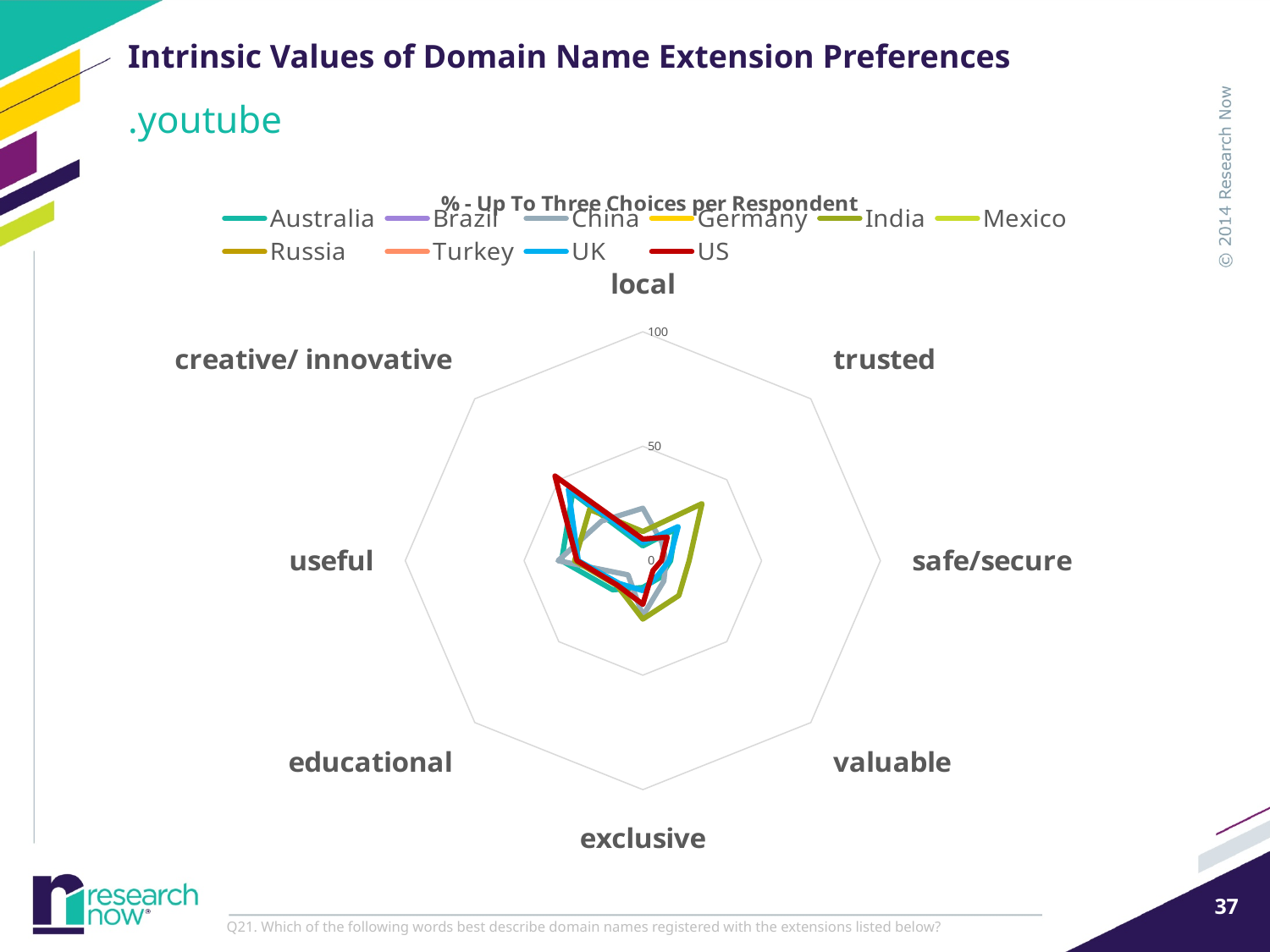
Is the value for US on the safe/secure axis greater or less than 50? less Which domain extension is the chart about? .youtube How many categories (axes) does the radar chart have? 8 How many series does the legend list? 10 What is the title of the chart? % - Up To Three Choices per Respondent What kind of chart is shown on the slide? radar chart Is the value for UK on the local axis greater or less than 50? less What is the maximum value shown on the radar chart's axis scale? 100